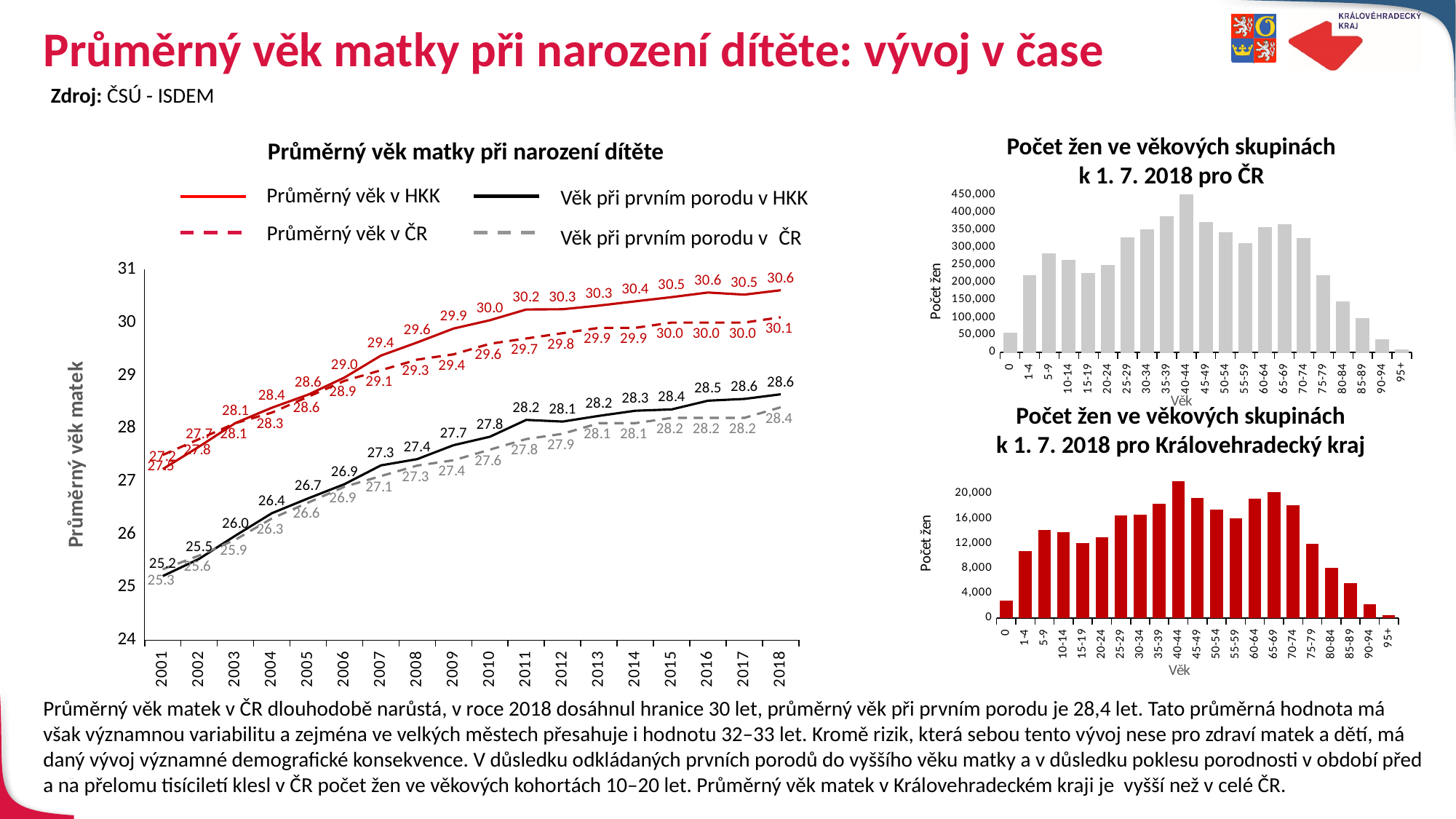
On the chart 'Počet žen ve věkových skupinách k 1. 7. 2018 pro Královehradecký kraj', is the value for age group 0 greater or less than 4,000? less What kind of chart is 'Počet žen ve věkových skupinách k 1. 7. 2018 pro ČR'? bar chart On the chart 'Průměrný věk matky při narození dítěte', how many series does the legend list? 4 On the chart 'Průměrný věk matky při narození dítěte', what is the value of 'Průměrný věk v ČR' in 2010? 29.6 On the chart 'Průměrný věk matky při narození dítěte', which is larger in 2011: 'Věk při prvním porodu v HKK' or 'Věk při prvním porodu v ČR'? Věk při prvním porodu v HKK On the chart 'Počet žen ve věkových skupinách k 1. 7. 2018 pro ČR', which age group has the highest value? 40-44 On the chart 'Průměrný věk matky při narození dítěte', how many years are shown on the x axis? 18 On the chart 'Průměrný věk matky při narození dítěte', do the values of 'Věk při prvním porodu v HKK' generally rise or fall from 2001 to 2018? rise On the chart 'Průměrný věk matky při narození dítěte', what is the difference between 'Průměrný věk v HKK' and 'Průměrný věk v ČR' in 2018? 0.5 On the chart 'Průměrný věk matky při narození dítěte', what is the value of 'Věk při prvním porodu v ČR' in 2001? 25.3 On the chart 'Počet žen ve věkových skupinách k 1. 7. 2018 pro ČR', is the value for age group 40-44 greater or less than 400,000? greater On the chart 'Průměrný věk matky při narození dítěte', what is the value of 'Průměrný věk v HKK' in 2018? 30.6